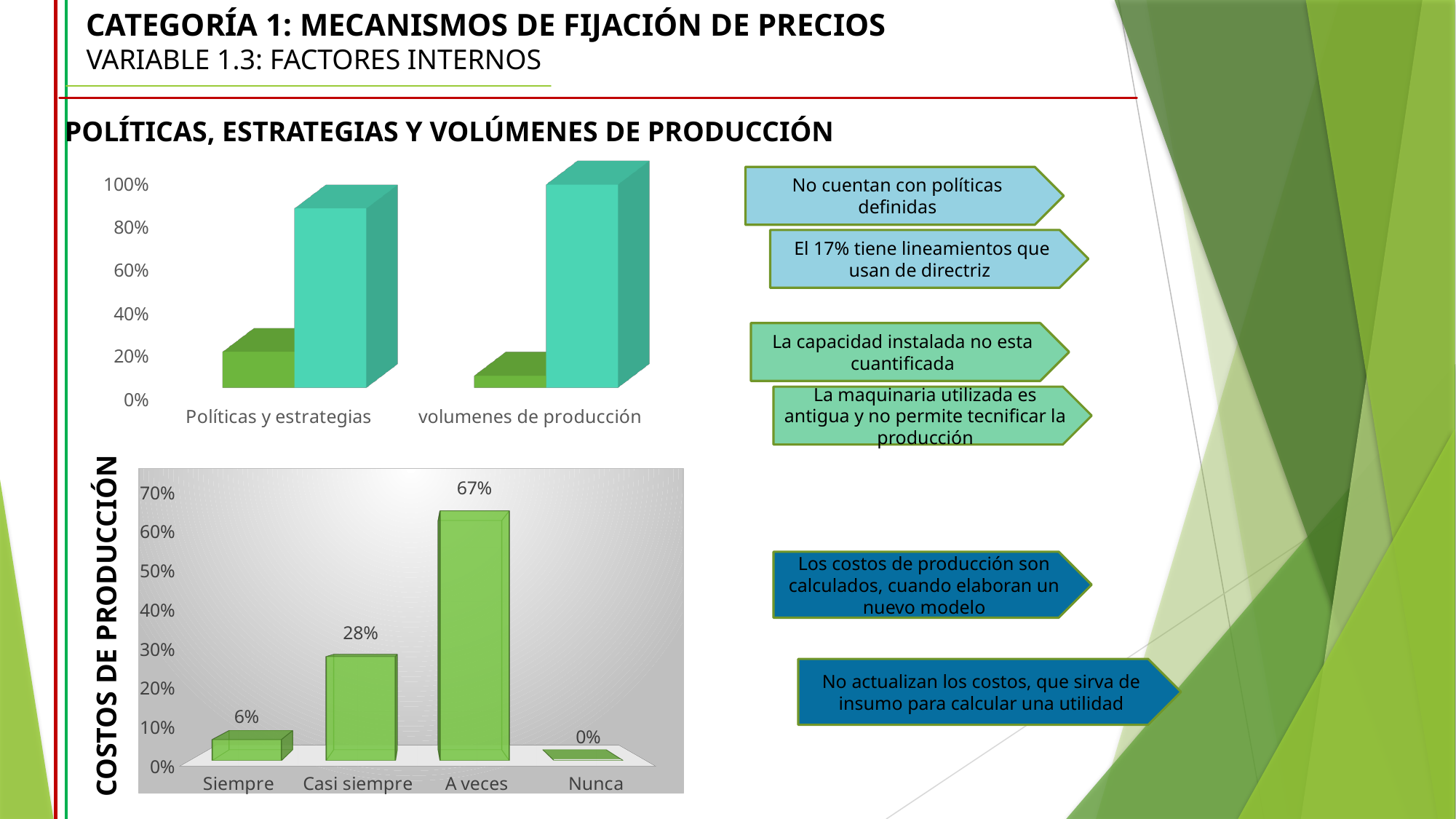
In the bottom chart (COSTOS DE PRODUCCIÓN), what is the value for 'A veces'? 67% In the top chart, is the value of the teal bar for 'volumenes de producción' greater or less than 80%? greater In the bottom chart (COSTOS DE PRODUCCIÓN), which category has the lowest value? Nunca In the bottom chart (COSTOS DE PRODUCCIÓN), which is larger, the value for 'Siempre' or the value for 'Casi siempre'? Casi siempre In the bottom chart (COSTOS DE PRODUCCIÓN), what is the value for 'Casi siempre'? 28% In the bottom chart (COSTOS DE PRODUCCIÓN), what is the difference between the values for 'A veces' and 'Casi siempre'? 39% In the top chart, is the value of the green bar for 'volumenes de producción' greater or less than 20%? less What kind of chart is the bottom chart (COSTOS DE PRODUCCIÓN)? Bar chart In the bottom chart (COSTOS DE PRODUCCIÓN), what is the value for 'Siempre'? 6% In the bottom chart (COSTOS DE PRODUCCIÓN), which category has the highest value? A veces How many categories are shown in the bottom chart (COSTOS DE PRODUCCIÓN)? 4 How many categories are shown on the x axis of the top chart? 2